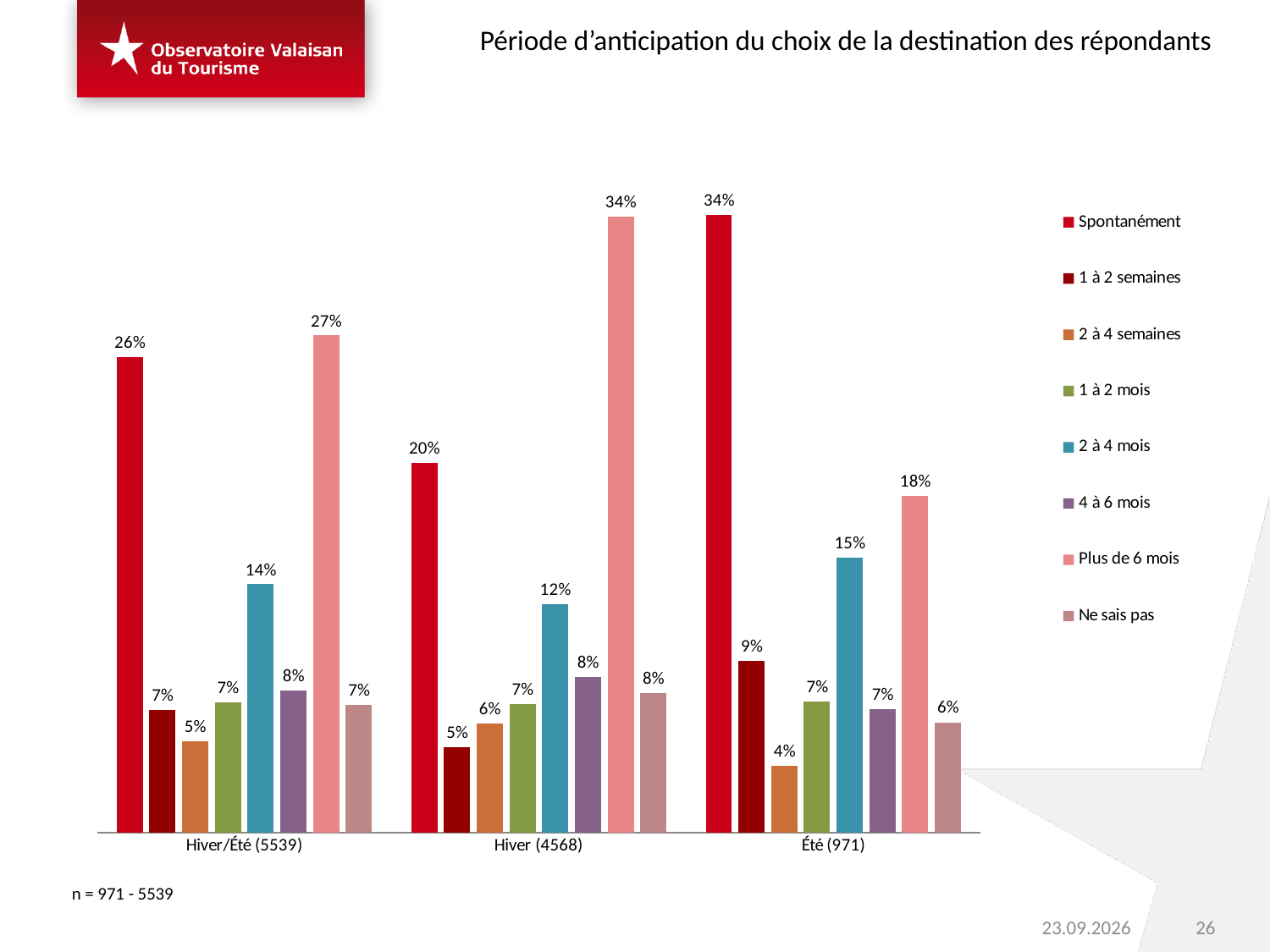
How many series does the legend list? 8 How many groups are shown on the x axis? 3 What is the value for "Spontanément" in the Été (971) group? 34% What is the value for "2 à 4 semaines" in the Été (971) group? 4% What is the value for "2 à 4 mois" in the Hiver/Été (5539) group? 14% Which is larger in the Hiver (4568) group: "Spontanément" or "Plus de 6 mois"? Plus de 6 mois Which series has the highest value in the Hiver/Été (5539) group? Plus de 6 mois Which series has the lowest value in the Été (971) group? 2 à 4 semaines What kind of chart is shown on the slide? Bar chart What is the value for "Plus de 6 mois" in the Hiver (4568) group? 34% What is the difference between "Spontanément" and "Plus de 6 mois" in the Été (971) group? 16% What is the title of the chart? Période d'anticipation du choix de la destination des répondants